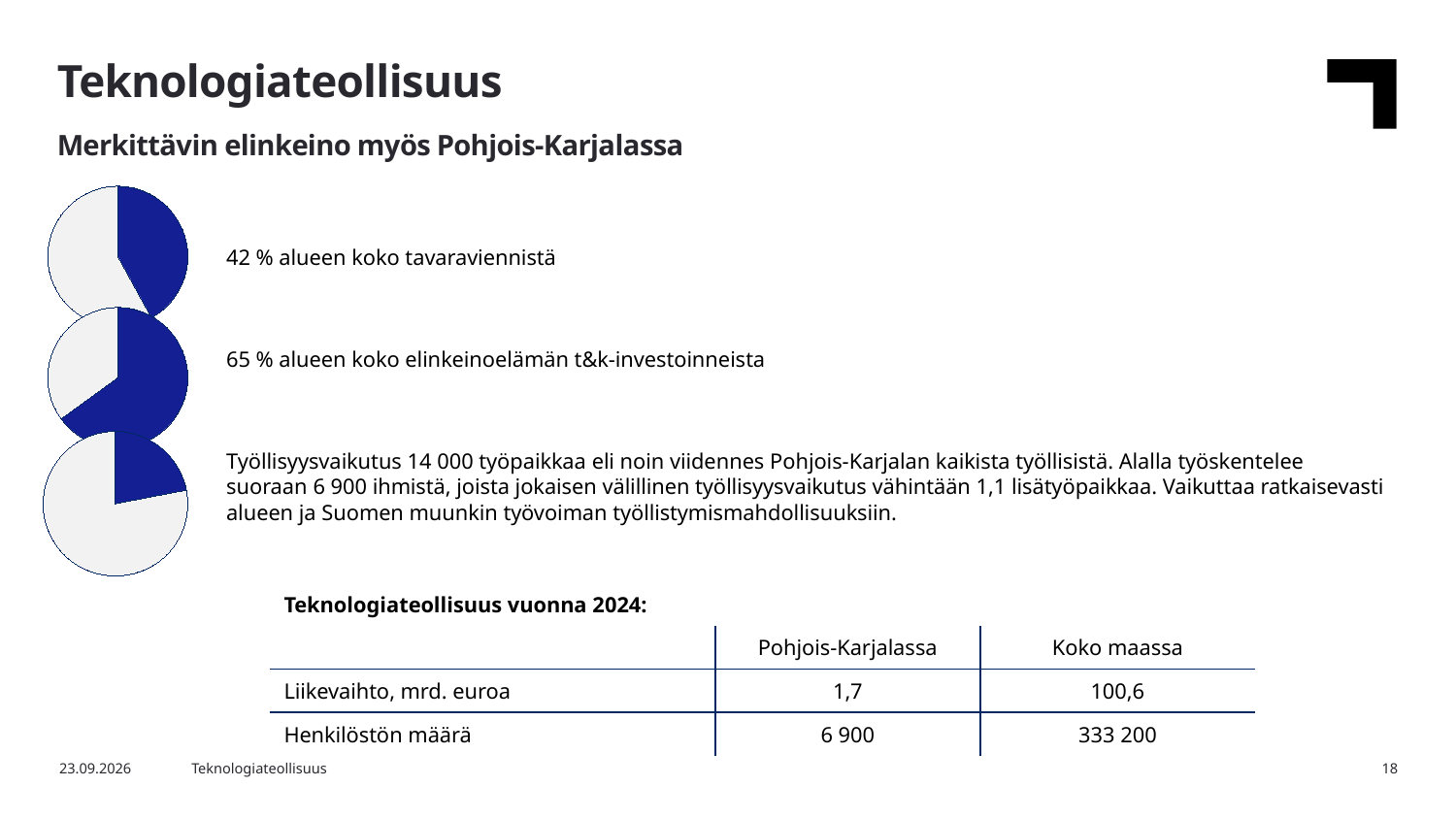
Is the blue slice larger in the top pie chart or in the middle pie chart? Middle What kind of charts are shown on the left side of the slide? Pie charts What does the top pie chart's 42 % share refer to, according to the text next to it? Alueen koko tavaraviennistä (the region's total goods exports) In the top pie chart, what share does the blue slice represent? 42 % What colour is used for the highlighted slice in the pie charts? Dark blue Is the blue slice in the bottom pie chart more or less than half of the pie? Less In the middle pie chart, what share does the blue slice represent? 65 % What is the difference in percentage points between the blue slice of the middle pie chart (65 %) and the top pie chart (42 %)? 23 percentage points How many pie charts are on the slide? 3 Which pie chart has the largest blue slice: the top, middle or bottom one? Middle Which pie chart has the smallest blue slice: the top, middle or bottom one? Bottom